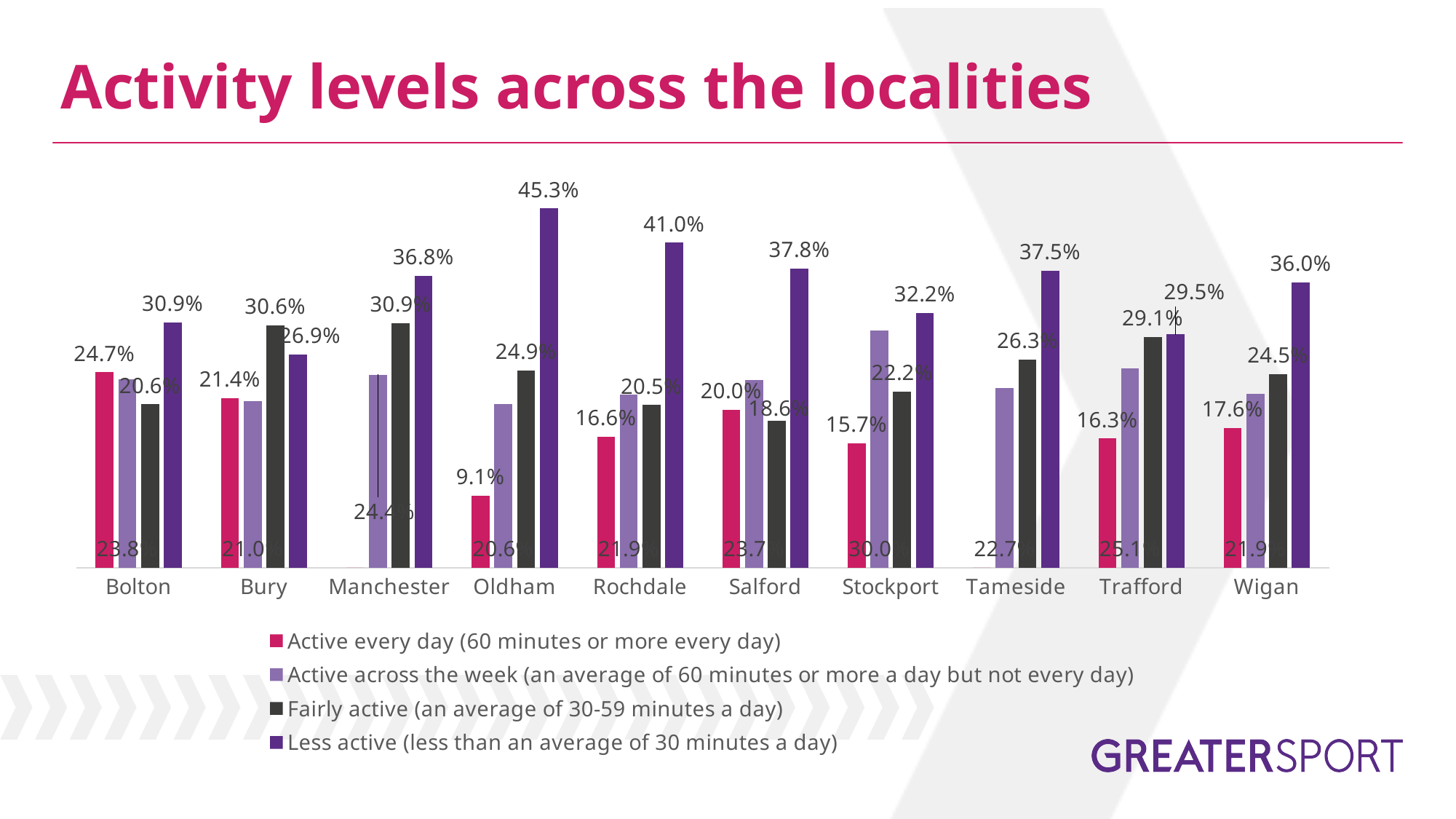
What is the 'Less active' value for Oldham? 45.3% What kind of chart is shown on the slide? Bar chart Which locality has the highest 'Less active' value? Oldham How many localities are shown on the x axis? 10 What is the title of the chart? Activity levels across the localities What is the 'Active every day' value for Stockport? 15.7% What is the 'Active every day' value for Bolton? 24.7% What is the difference between the 'Less active' values for Oldham and Rochdale? 4.3 percentage points What is the 'Fairly active' value for Trafford? 29.1% Which locality has the lowest 'Active every day' value? Oldham For Bury, which is larger: the 'Fairly active' value or the 'Less active' value? Fairly active How many series does the legend list? 4